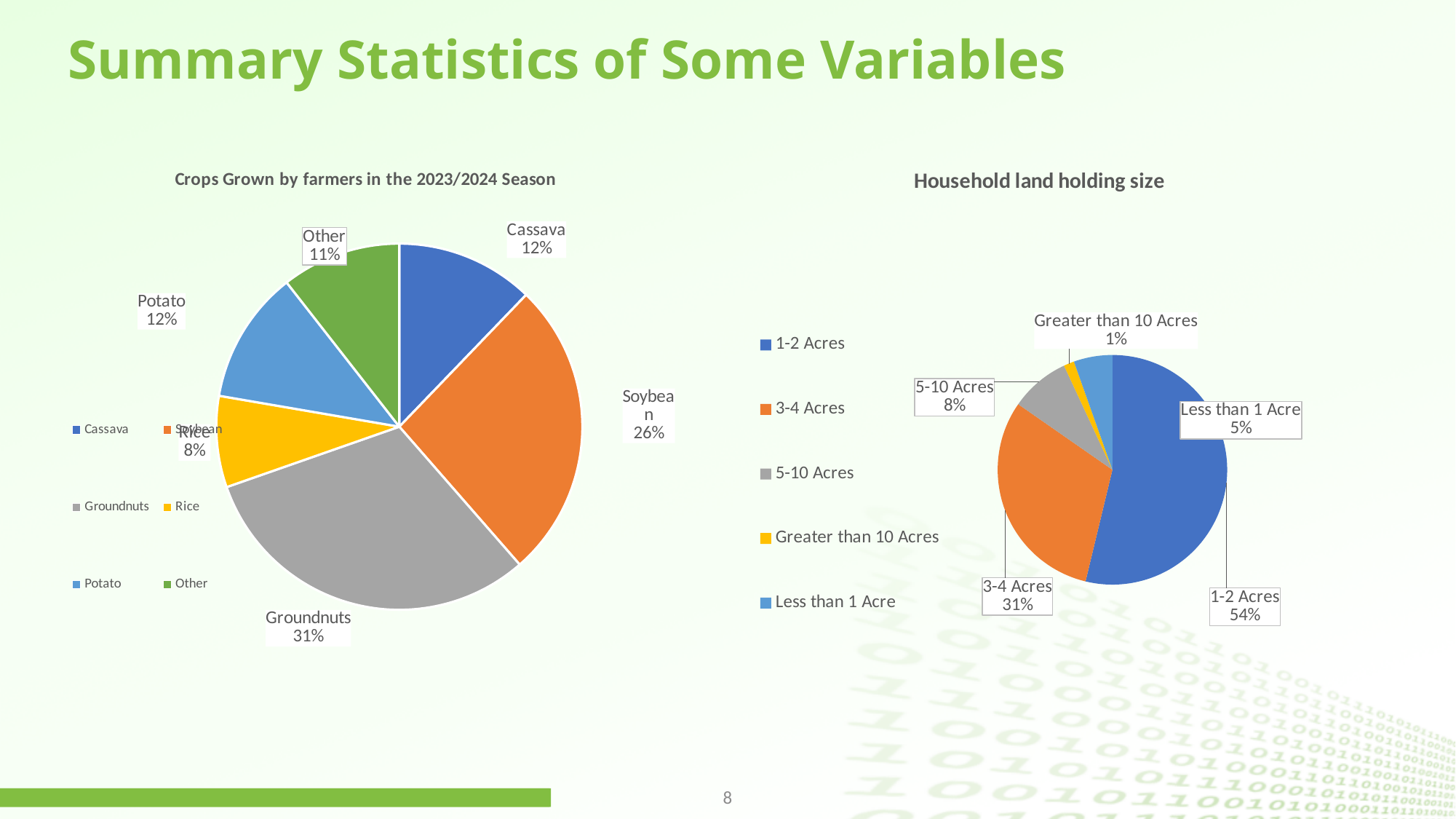
In the 'Crops Grown by farmers in the 2023/2024 Season' chart, what is the difference in percentage points between Groundnuts and Other? 20 In the 'Crops Grown by farmers in the 2023/2024 Season' chart, what share of the pie is Groundnuts? 31% In the 'Crops Grown by farmers in the 2023/2024 Season' chart, what share of the pie is Soybean? 26% In the 'Crops Grown by farmers in the 2023/2024 Season' chart, how many crop categories are shown? 6 In the 'Household land holding size' chart, which category has the largest share? 1-2 Acres In the 'Household land holding size' chart, what share of the pie is 1-2 Acres? 54% In the 'Household land holding size' chart, what share of the pie is Greater than 10 Acres? 1% What kind of chart is the 'Household land holding size' chart? Pie chart In the 'Household land holding size' chart, which is larger: 3-4 Acres or 5-10 Acres? 3-4 Acres In the 'Crops Grown by farmers in the 2023/2024 Season' chart, which crop has the largest share? Groundnuts In the 'Household land holding size' chart, how many categories does the legend list? 5 In the 'Crops Grown by farmers in the 2023/2024 Season' chart, which crop has the smallest share? Rice